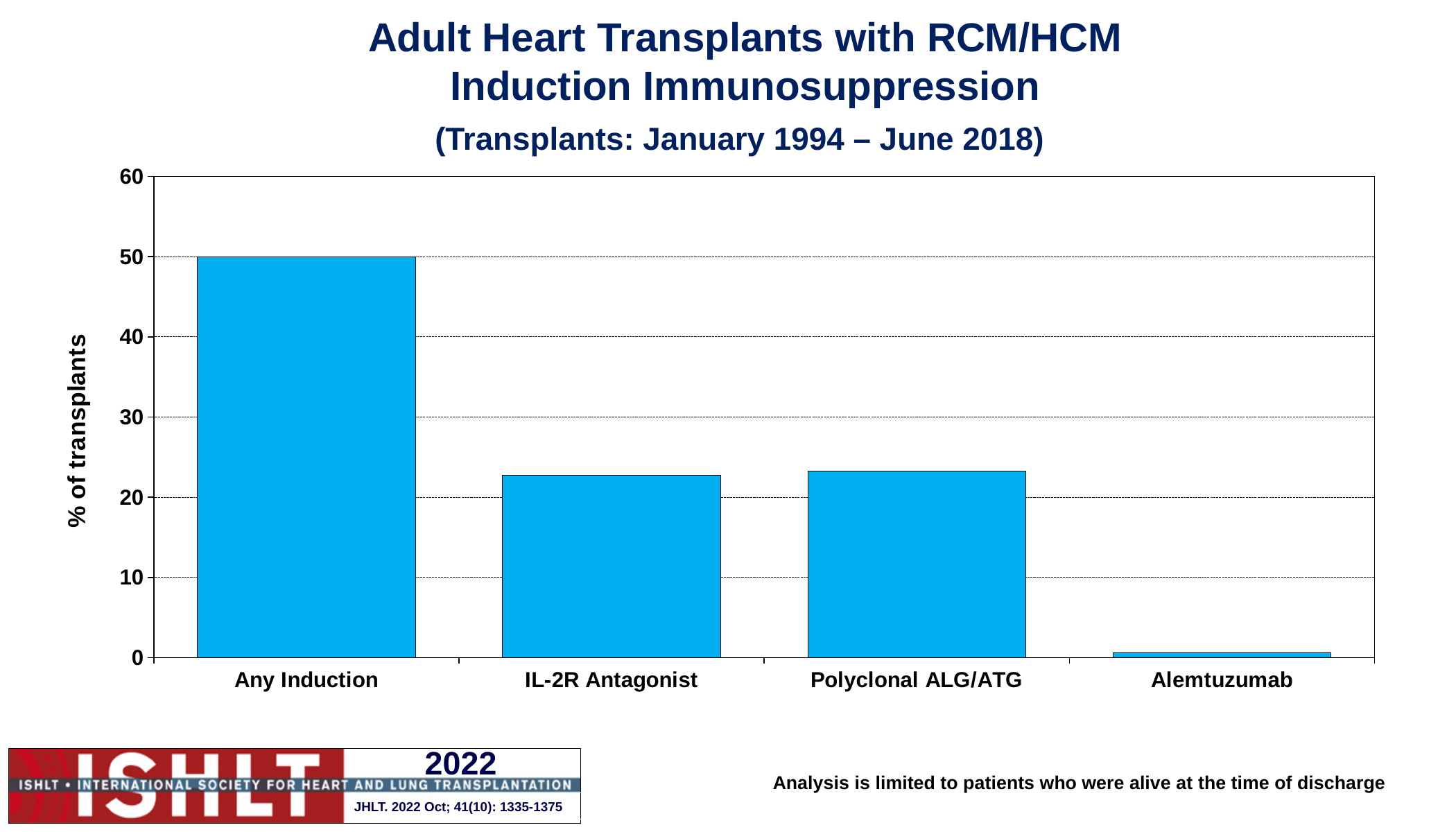
What transplant date range is given in the chart subtitle? January 1994 – June 2018 How many categories are shown on the x axis? 4 Which is larger, the value for Polyclonal ALG/ATG or the value for Alemtuzumab? Polyclonal ALG/ATG Is the value for IL-2R Antagonist greater or less than 20? greater What kind of chart is shown on the slide? bar chart What is the % of transplants for Any Induction? 50 Is the value for Alemtuzumab greater or less than 10? less Which category has the highest % of transplants? Any Induction Which is larger, the value for Any Induction or the value for IL-2R Antagonist? Any Induction Is the value for Polyclonal ALG/ATG greater or less than 30? less Which category has the lowest % of transplants? Alemtuzumab What is the label of the y axis? % of transplants